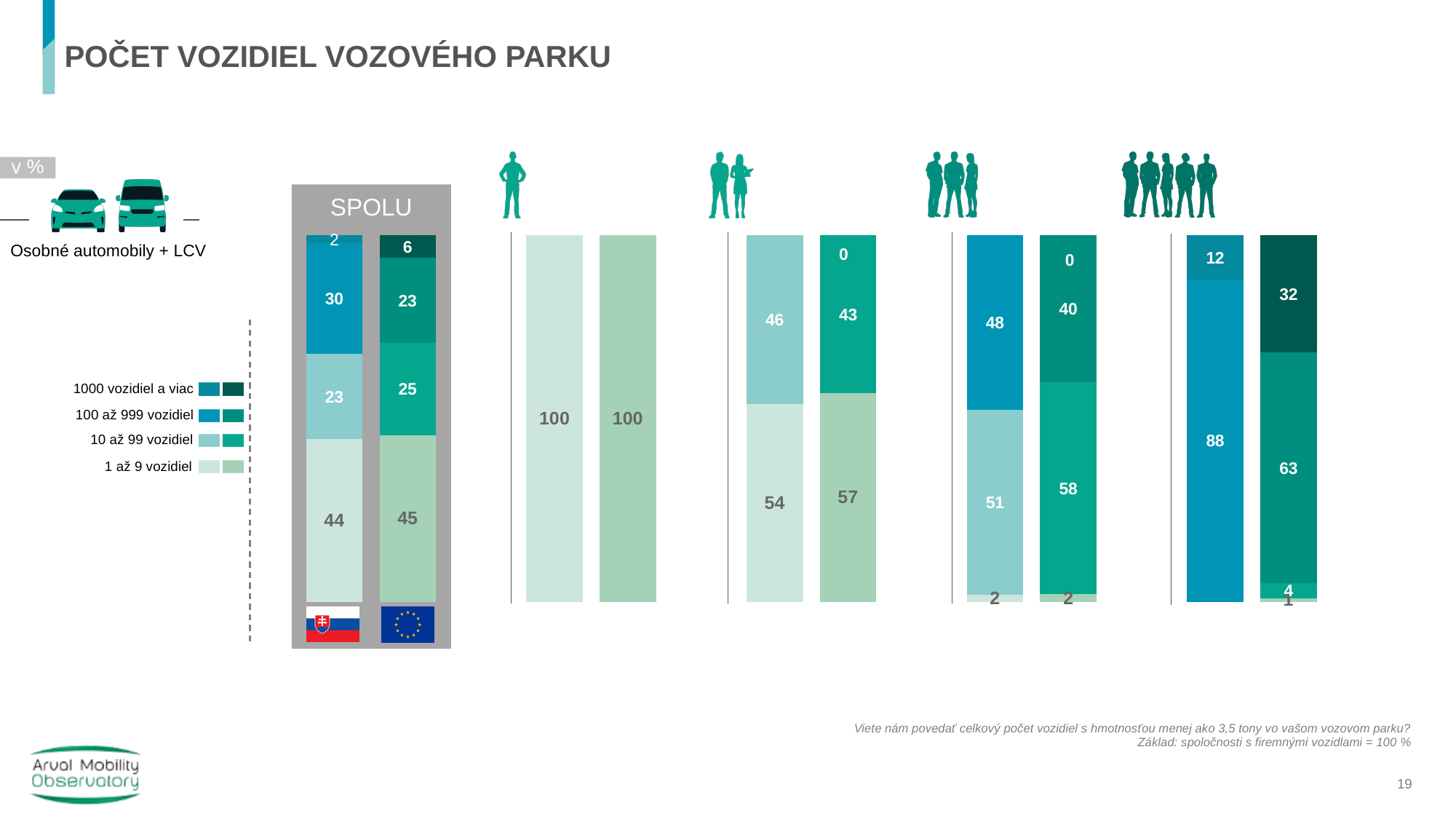
How many fleet-size categories does the legend list? 4 What kind of chart is shown on the slide? Stacked bar chart In the rightmost group (largest companies icon), what is the value for 100 až 999 vozidiel in the Slovak bar? 88 In the SPOLU group, what is the value for 1000 vozidiel a viac in the Slovak bar? 2 In the SPOLU group, what is the difference between the Slovak and EU values for 100 až 999 vozidiel? 7 In the rightmost group (largest companies icon), what is the value for 1000 vozidiel a viac in the EU bar? 32 In what unit are the values on the chart expressed? v % In the SPOLU group, what percentage of Slovak companies have 1 až 9 vozidiel? 44 In the SPOLU group, what is the value for 1000 vozidiel a viac in the EU bar? 6 In the SPOLU group, which bar has the larger value for 1 až 9 vozidiel, Slovakia or the EU? EU In the group with the three-person icon, what is the value for 10 až 99 vozidiel in the Slovak bar? 51 In the SPOLU group, what percentage of EU companies have 100 až 999 vozidiel? 23